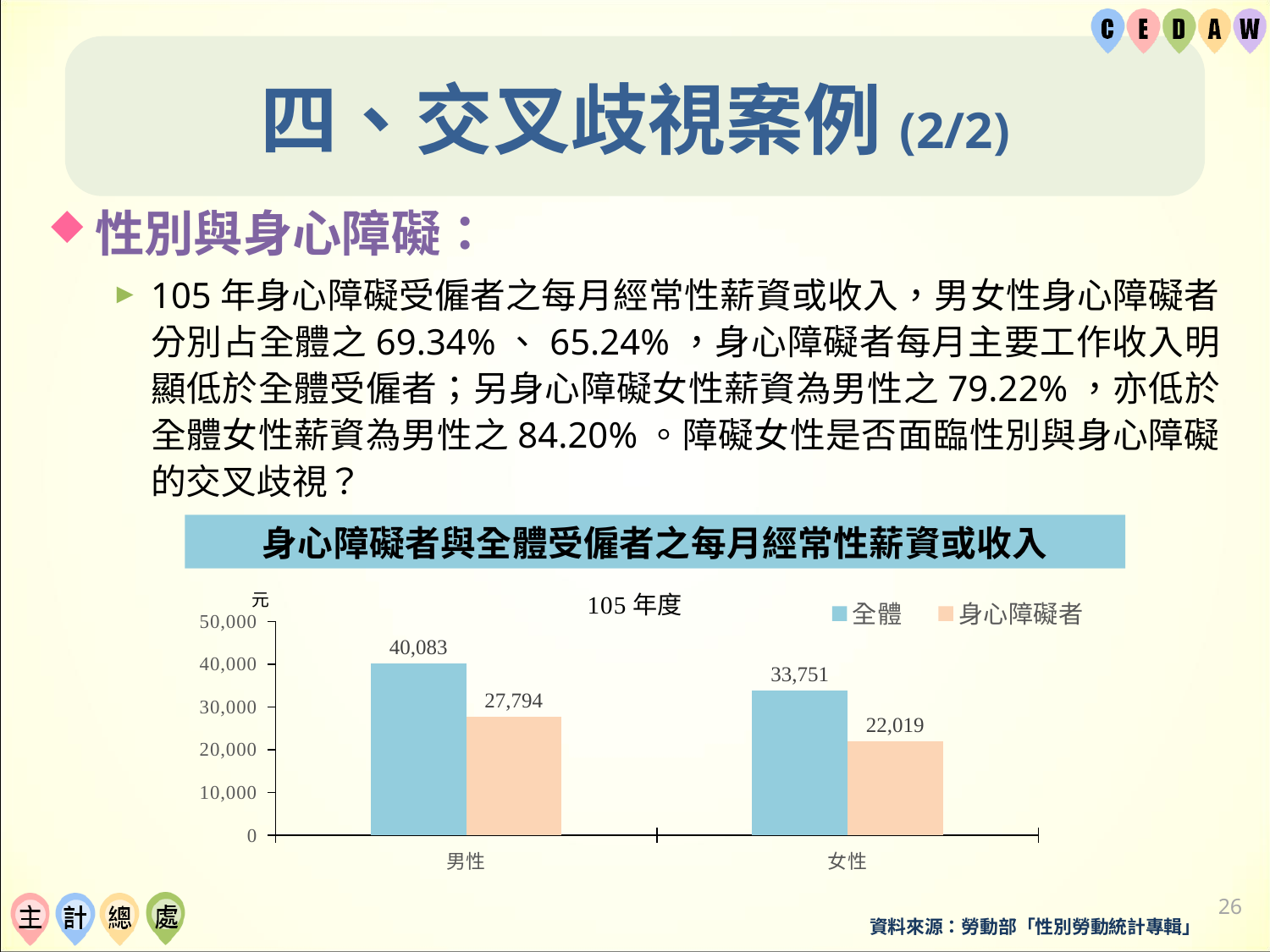
How many series does the legend list? 2 What is the value for 身心障礙者 in the 男性 category? 27,794 Which bar has the lowest value in the chart? 身心障礙者, 女性 How many categories are shown on the x axis? 2 What is the value for 全體 in the 男性 category? 40,083 What is the value for 全體 in the 女性 category? 33,751 What is the difference between the 全體 values for 男性 and 女性? 6,332 What is the difference between 全體 and 身心障礙者 in the 男性 category? 12,289 Which is larger: 身心障礙者 for 男性 or 全體 for 女性? 全體 for 女性 What is the value for 身心障礙者 in the 女性 category? 22,019 What kind of chart is shown on the slide? Bar chart Which bar has the highest value in the chart? 全體, 男性